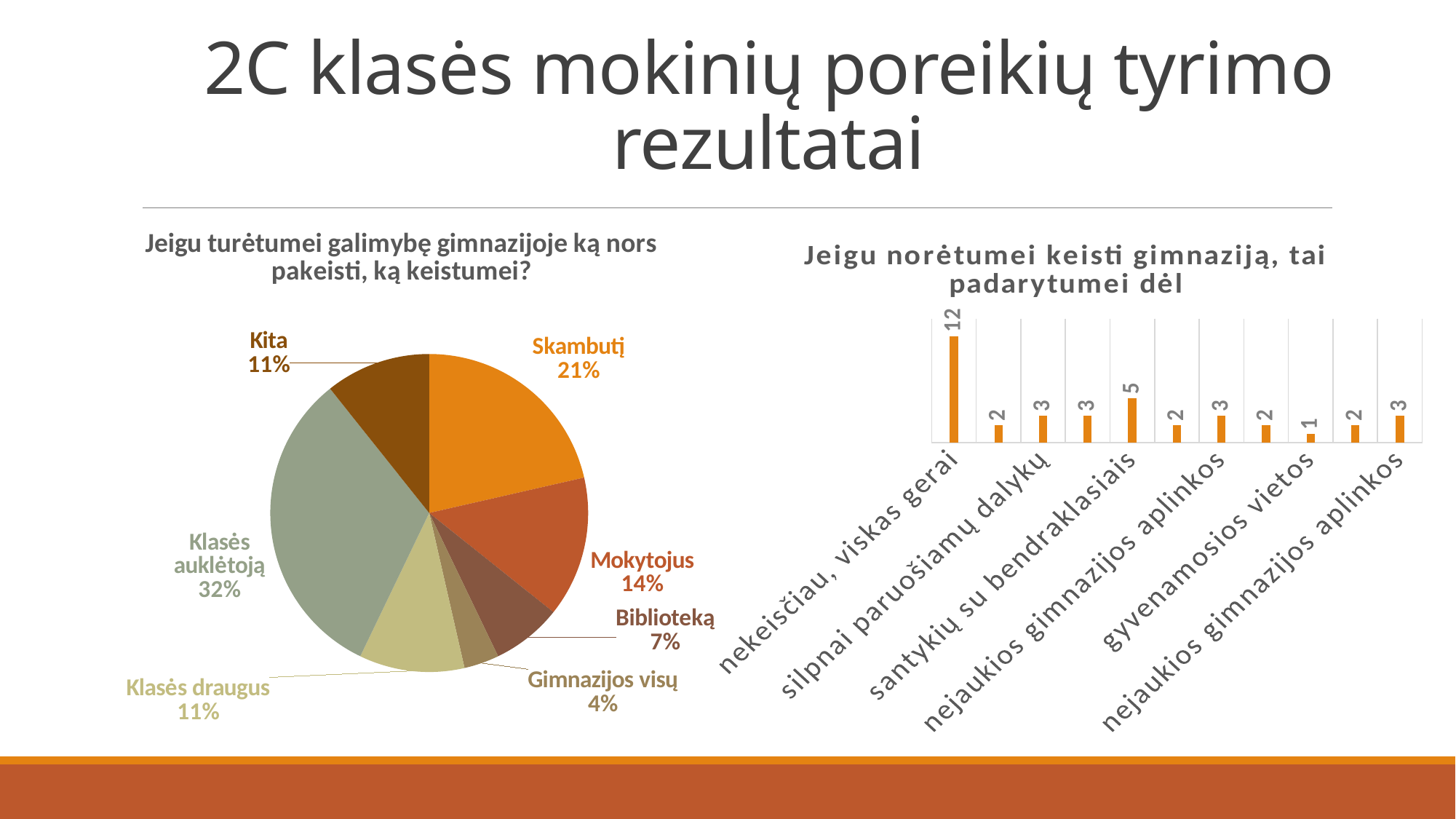
What kind of chart is the chart on the right titled 'Jeigu norėtumei keisti gimnaziją, tai padarytumei dėl'? bar chart On the pie chart on the left, what percentage is shown for Biblioteką? 7% On the pie chart on the left, what percentage is shown for Klasės auklėtoją? 32% On the pie chart on the left, which is larger: Skambutį or Mokytojus? Skambutį On the pie chart on the left, what percentage is shown for Skambutį? 21% On the pie chart on the left, which category has the smallest share? Gimnazijos visų On the bar chart on the right, how many bars are plotted? 11 On the bar chart on the right, what is the highest value shown on any bar? 12 On the pie chart on the left, what is the difference in percentage points between Mokytojus and Biblioteką? 7 On the pie chart on the left, how many slices does the pie have? 7 On the bar chart on the right, what is the value for 'nekeisčiau, viskas gerai'? 12 On the pie chart on the left, which category has the largest share? Klasės auklėtoją